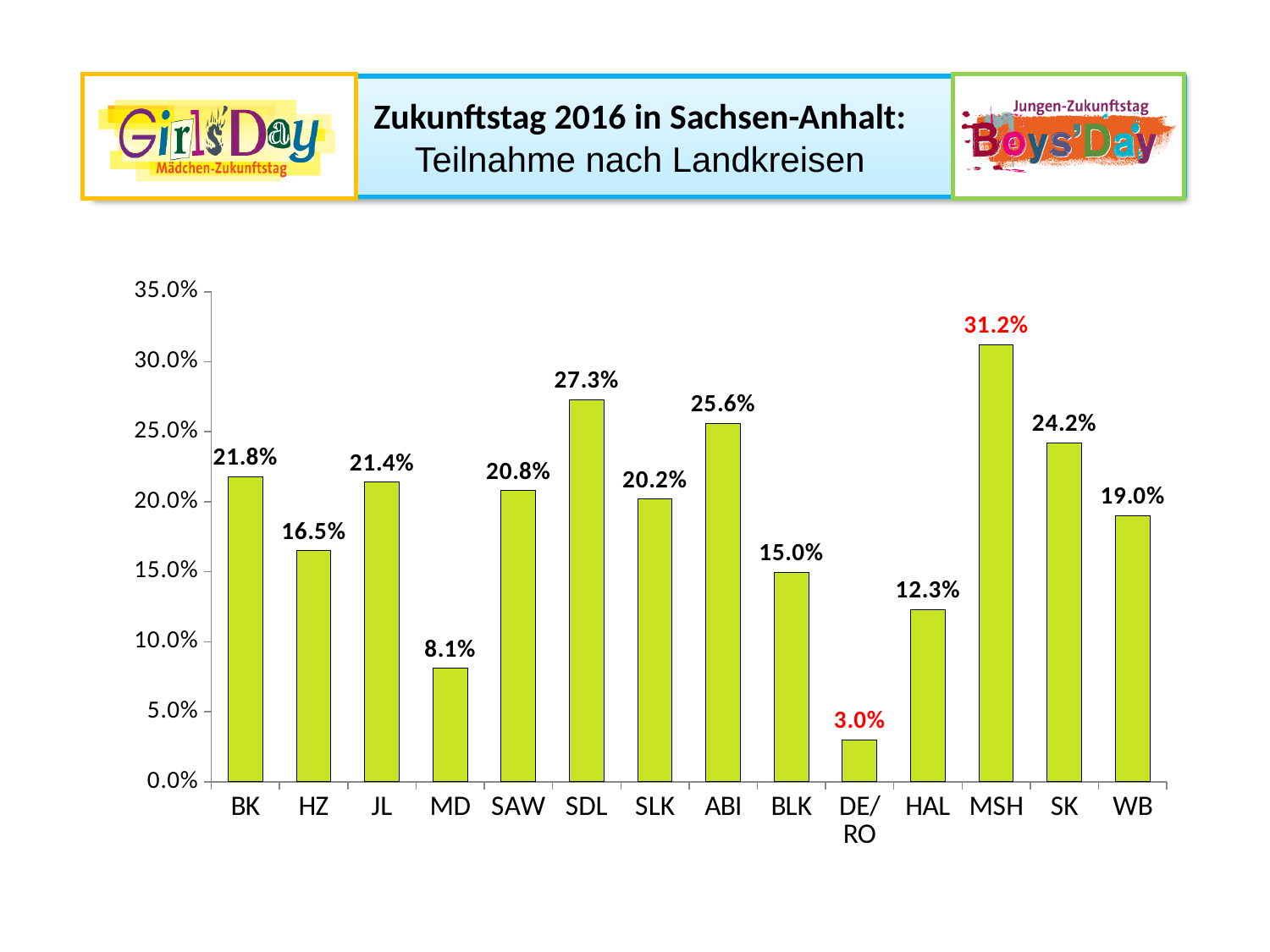
Which Landkreis has the lowest value? DE/RO How many Landkreise are shown on the x axis? 14 What is the value for MSH? 31.2% What is the value for DE/RO? 3.0% What is the difference between the values for MSH and DE/RO? 28.2% What is the value for SAW? 20.8% What kind of chart is shown on the slide? bar chart What is the difference between the values for SDL and SLK? 7.1% Which is larger, the value for ABI or the value for SK? ABI Which Landkreis has the highest value? MSH Is the value for HAL greater or less than 15.0%? less Which two data labels are printed in red? 31.2% (MSH) and 3.0% (DE/RO)